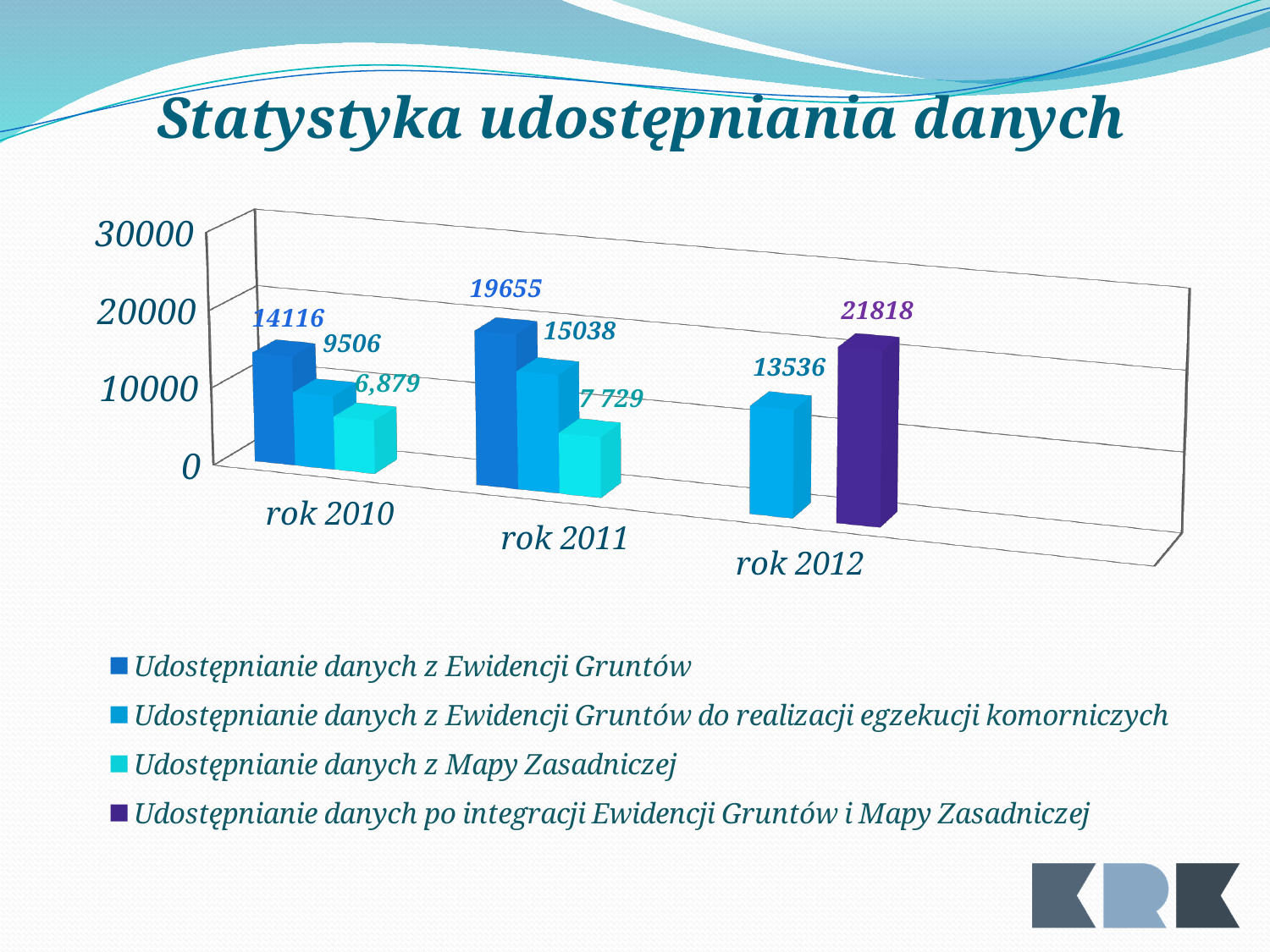
Which year has the highest value for 'Udostępnianie danych z Ewidencji Gruntów do realizacji egzekucji komorniczych'? rok 2011 What is the value for 'Udostępnianie danych z Ewidencji Gruntów' in rok 2011? 19655 What is the value for 'Udostępnianie danych z Ewidencji Gruntów do realizacji egzekucji komorniczych' in rok 2012? 13536 What is the value for 'Udostępnianie danych z Mapy Zasadniczej' in rok 2010? 6,879 What is the difference between the 'Udostępnianie danych z Ewidencji Gruntów' values in rok 2011 and rok 2010? 5539 Which is larger: 'Udostępnianie danych z Ewidencji Gruntów' in rok 2011 or 'Udostępnianie danych po integracji Ewidencji Gruntów i Mapy Zasadniczej' in rok 2012? Udostępnianie danych po integracji Ewidencji Gruntów i Mapy Zasadniczej in rok 2012 How many year categories are shown on the x axis? 3 What is the value for 'Udostępnianie danych z Ewidencji Gruntów' in rok 2010? 14116 What kind of chart is shown on the slide? bar chart How many series does the legend list? 4 What is the title of the chart? Statystyka udostępniania danych What is the value for 'Udostępnianie danych po integracji Ewidencji Gruntów i Mapy Zasadniczej' in rok 2012? 21818